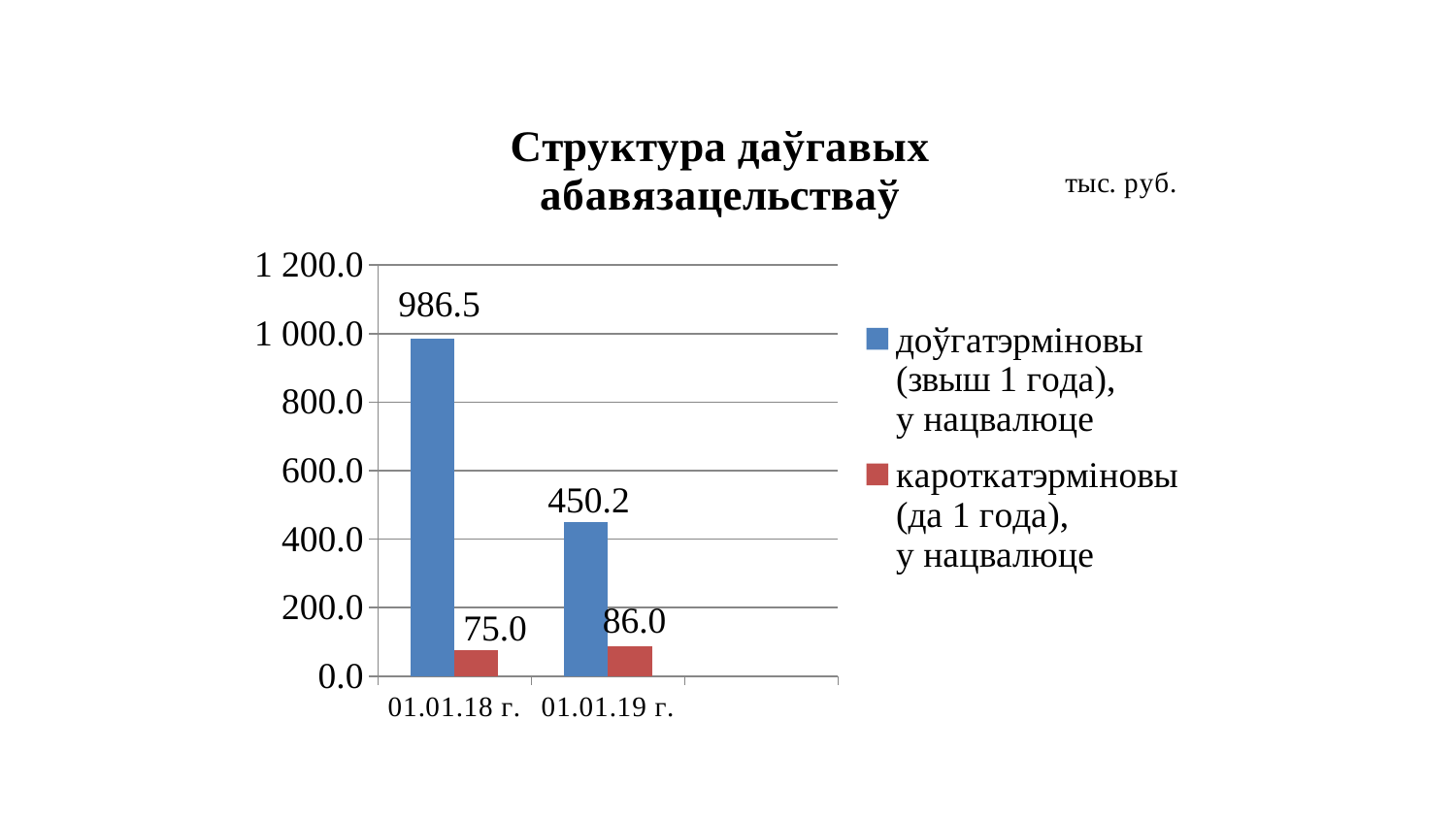
How many series does the legend list? 2 What unit is indicated next to the chart title? тыс. руб. What is the difference between the long-term values for 01.01.18 г. and 01.01.19 г.? 536.3 What is the value of the long-term (доўгатэрміновы) series for 01.01.19 г.? 450.2 What is the value of the short-term (кароткатэрміновы) series for 01.01.19 г.? 86.0 Which date has the higher value for the long-term (доўгатэрміновы) series? 01.01.18 г. What kind of chart is shown on the slide? bar chart Which date has the lower value for the short-term (кароткатэрміновы) series? 01.01.18 г. What is the value of the long-term (доўгатэрміновы) series for 01.01.18 г.? 986.5 What is the value of the short-term (кароткатэрміновы) series for 01.01.18 г.? 75.0 What is the difference between the short-term values for 01.01.19 г. and 01.01.18 г.? 11.0 Is the short-term value for 01.01.19 г. larger or smaller than the short-term value for 01.01.18 г.? larger